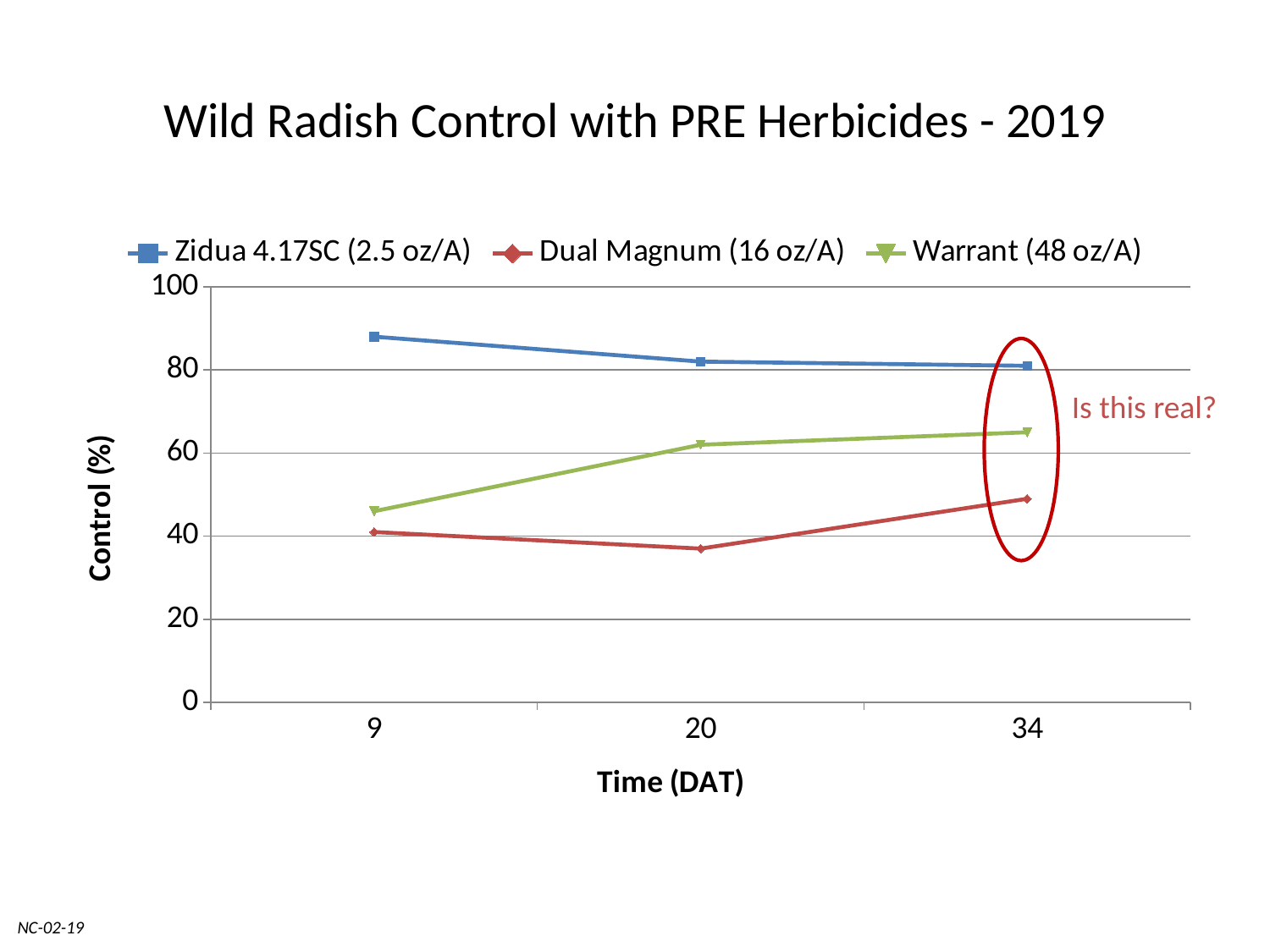
Is the value for Warrant (48 oz/A) at 34 DAT greater or less than 60? greater What is the label on the y axis? Control (%) How many time points are plotted along the x axis? 3 Does the Warrant (48 oz/A) line rise or fall from 9 DAT to 34 DAT? rise Is the value for Warrant (48 oz/A) at 9 DAT greater or less than 60? less Which series has the highest control at 34 DAT? Zidua 4.17SC (2.5 oz/A) Is the value for Dual Magnum (16 oz/A) at 34 DAT greater or less than 60? less How many series does the legend list? 3 At 34 DAT, which is larger: the value for Zidua 4.17SC (2.5 oz/A) or the value for Warrant (48 oz/A)? Zidua 4.17SC (2.5 oz/A) Which series has the lowest control at 20 DAT? Dual Magnum (16 oz/A) What kind of chart is shown on the slide? Line chart